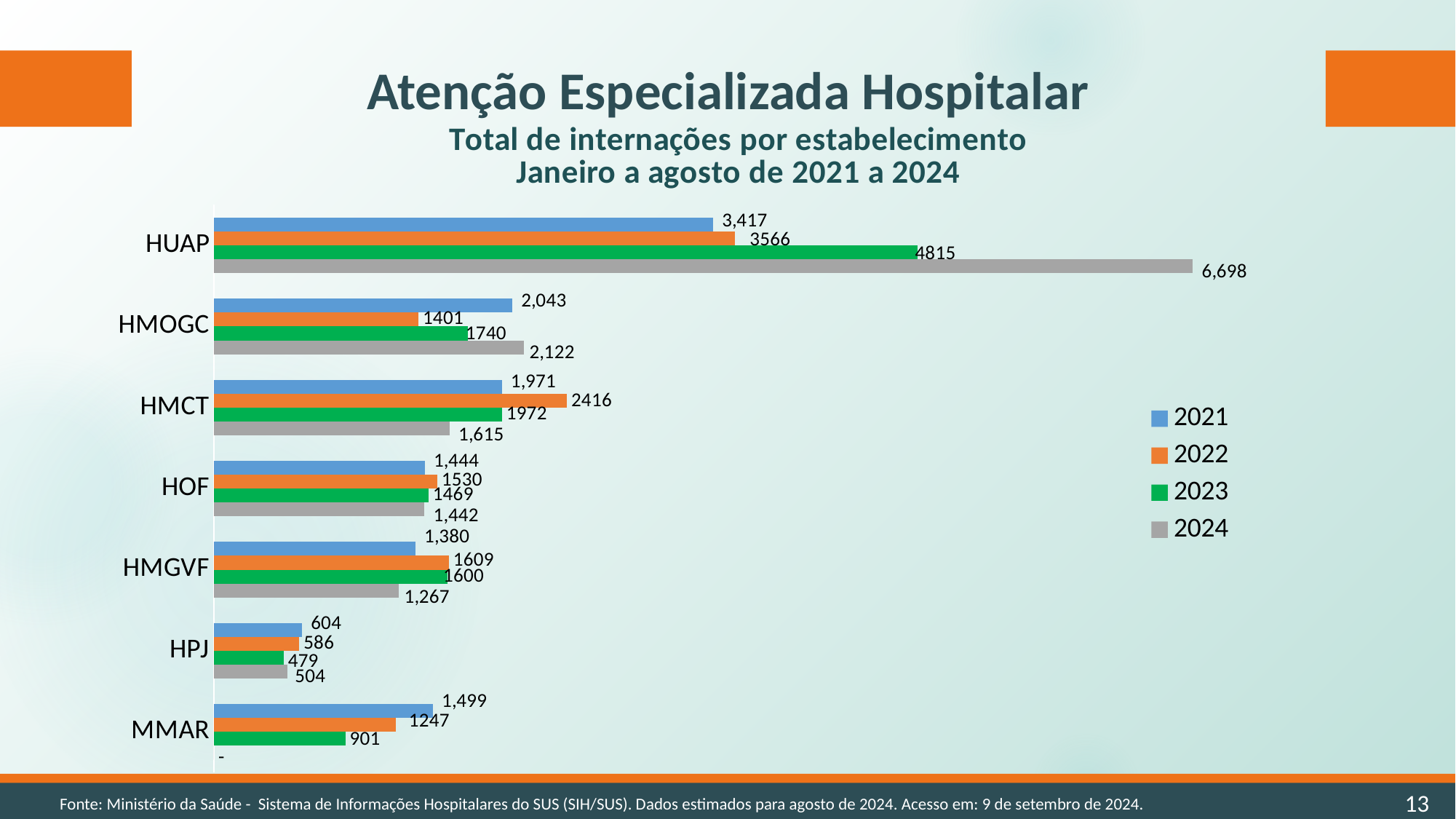
What is the value for HMCT in 2022? 2416 Do the values for HUAP rise or fall from 2021 to 2024? rise What is the difference between the 2024 and 2021 values for HUAP? 3,281 Which is larger for HMOGC: the 2021 value or the 2022 value? 2021 How many series does the legend list? 4 Which establishment has the lowest value in 2021? HPJ What is the value for HPJ in 2023? 479 Which series is shown in grey in the legend? 2024 What is the value for HUAP in 2024? 6,698 What kind of chart is shown on the slide? bar chart Which establishment has the highest value in 2024? HUAP How many establishments (categories) are shown on the chart? 7